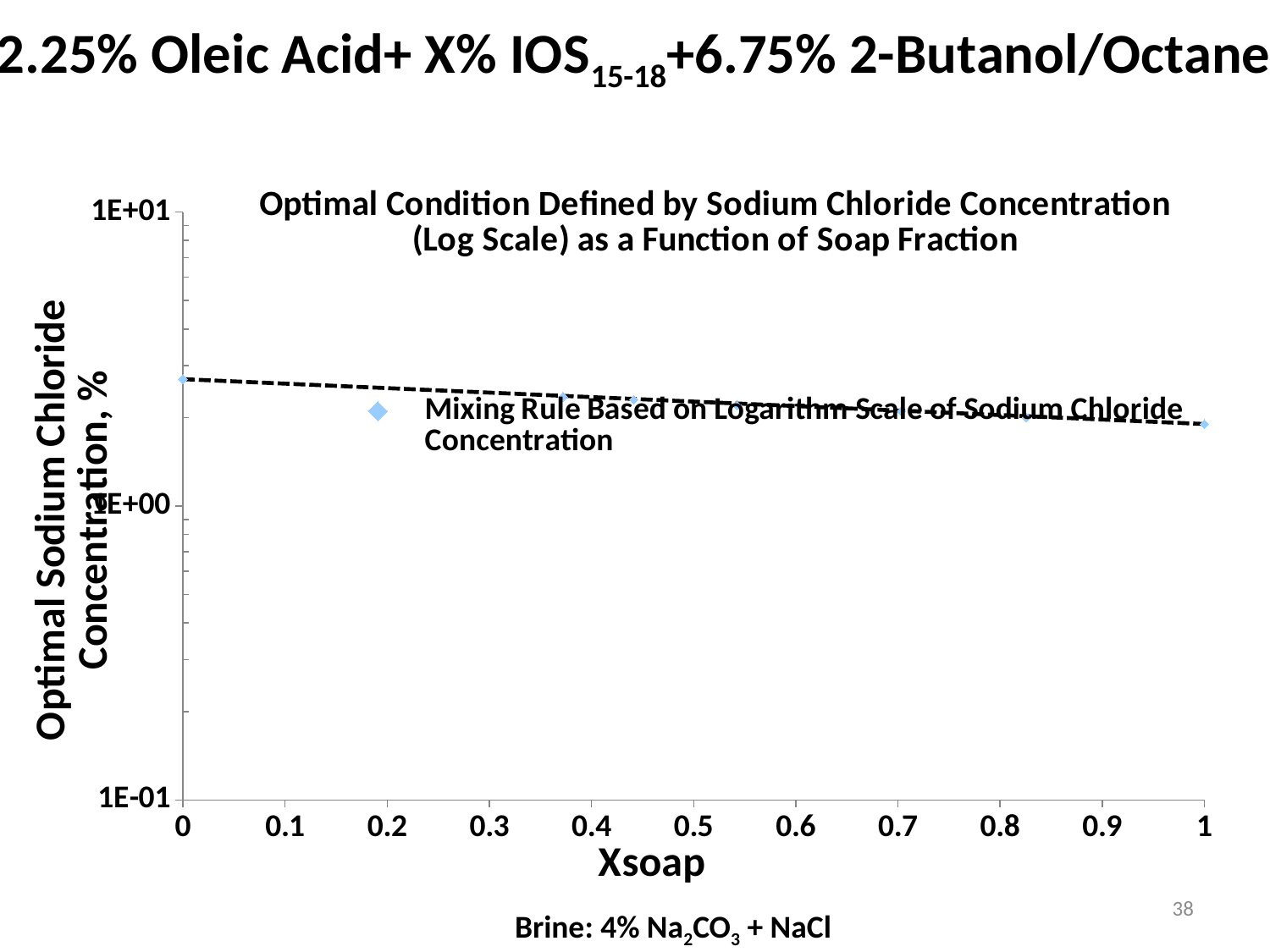
Which has the larger optimal sodium chloride concentration, Xsoap = 0 or Xsoap = 1? Xsoap = 0 At which Xsoap value is the optimal sodium chloride concentration highest? 0 What kind of chart is shown on the slide? scatter chart Is the value at Xsoap = 1 greater or less than 1E+00? greater How many series does the chart legend list? 1 Is the value at Xsoap = 1 greater or less than 1E+01? less Is the value at Xsoap = 0 greater or less than 1E+00? greater At which Xsoap value is the optimal sodium chloride concentration lowest? 1 What is the title of the chart? Optimal Condition Defined by Sodium Chloride Concentration (Log Scale) as a Function of Soap Fraction What is the label of the x axis? Xsoap Do the plotted values rise or fall as Xsoap increases from 0 to 1? fall